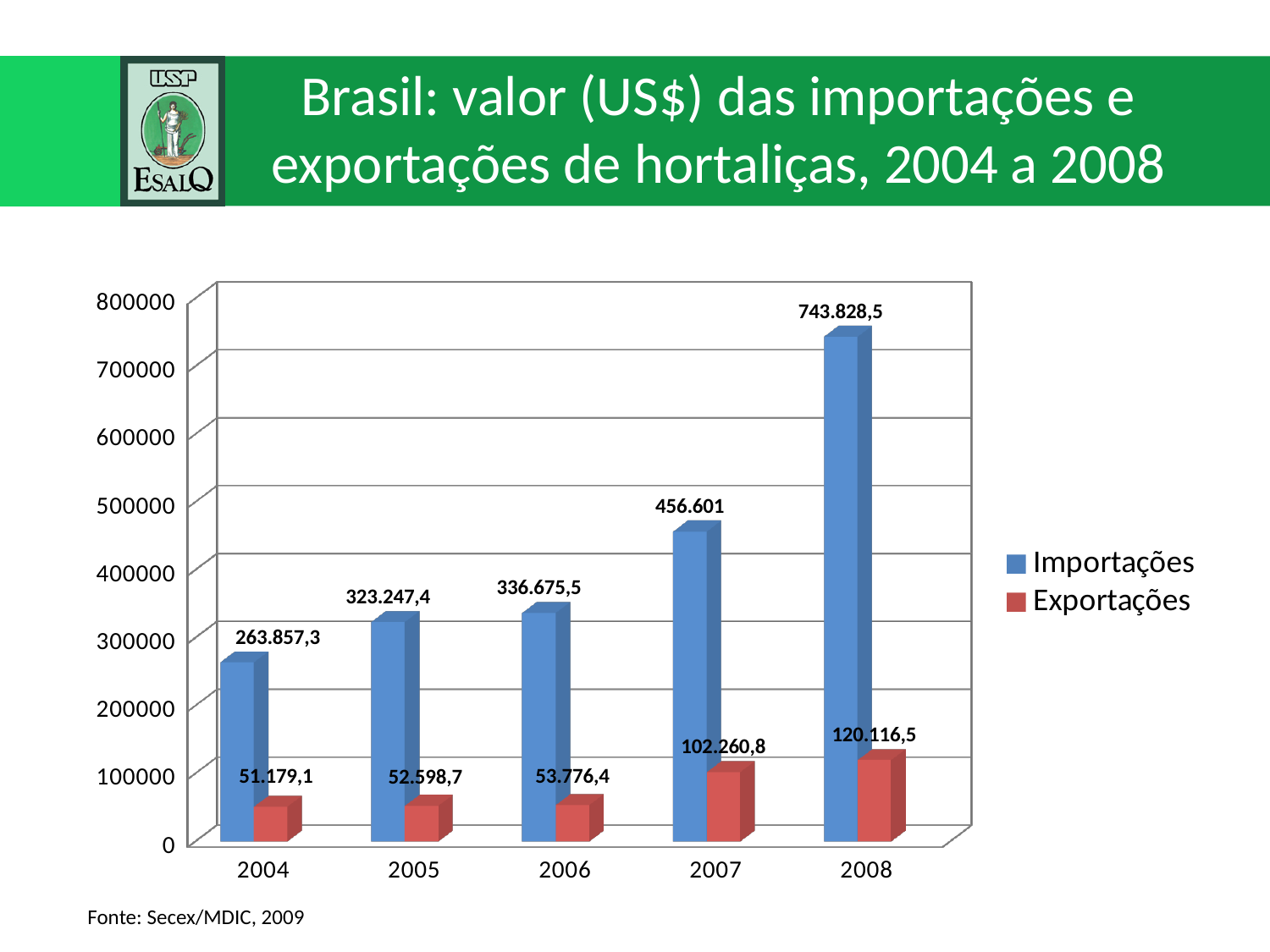
What is the difference between the Importações values for 2006 and 2005? 13.428,1 What is the value for Exportações in 2004? 51.179,1 What is the value for Importações in 2008? 743.828,5 What is the value for Exportações in 2007? 102.260,8 Which is larger, Importações in 2004 or Exportações in 2008? Importações in 2004 What is the value for Importações in 2007? 456.601 How many years are shown on the x axis? 5 In which year is the value for Importações highest? 2008 In which year is the value for Exportações lowest? 2004 How many series does the legend list? 2 What is the difference between Importações and Exportações in 2008? 623.712 Do the Importações values rise or fall from 2004 to 2008? rise